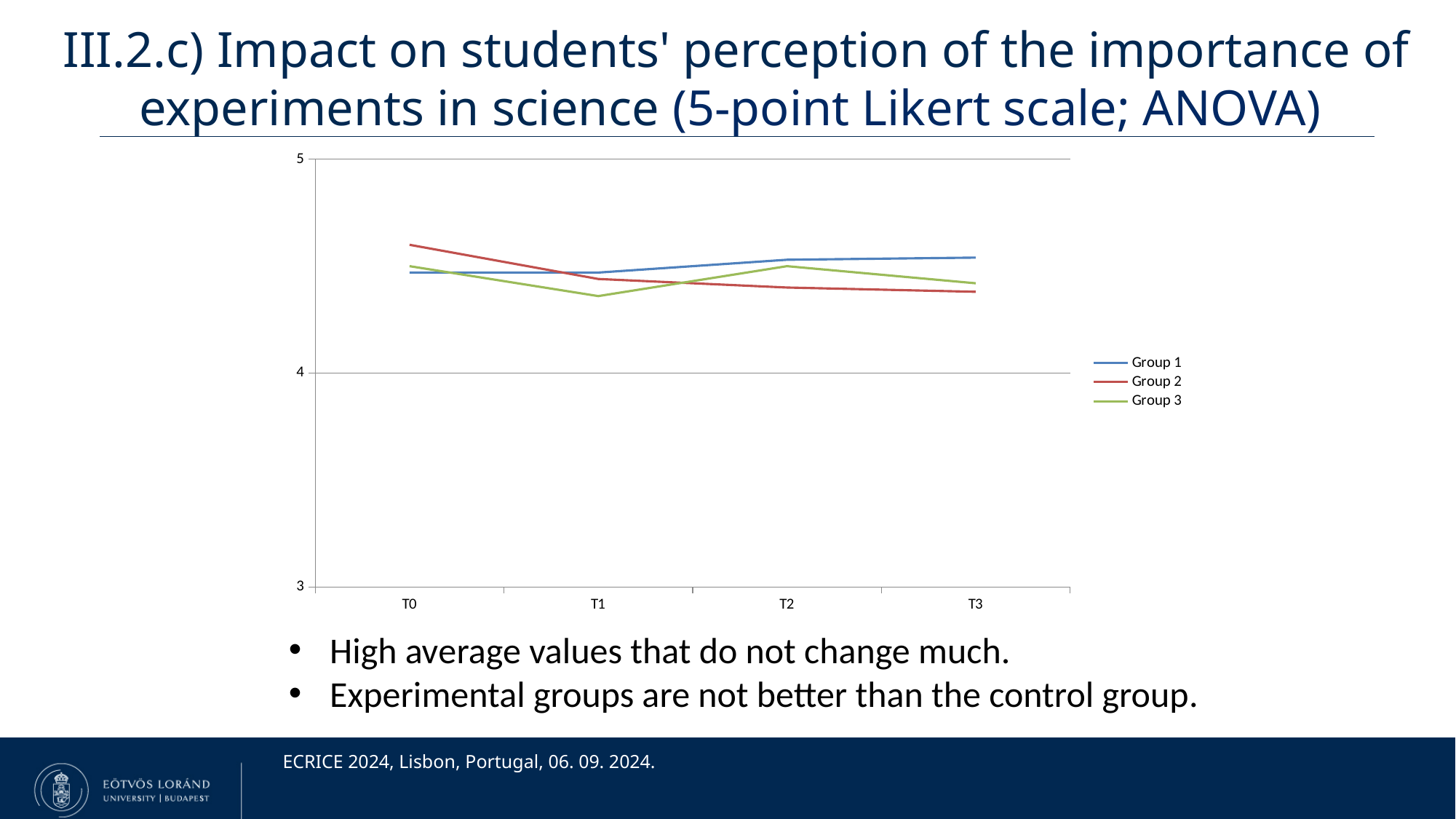
Does the value for Group 1 rise or fall from T0 to T3? rise At T3, which is larger: the value for Group 1 or the value for Group 2? Group 1 Which group has the lowest value at T1? Group 3 What kind of chart is shown on the slide? line chart What are the entries listed in the legend? Group 1, Group 2, Group 3 How many time points are shown on the x axis? 4 Is the value for Group 2 at T3 greater or less than 4? greater Does the value for Group 2 rise or fall from T0 to T3? fall Which group has the lowest value at T3? Group 2 Which group has the highest value at T3? Group 1 How many series does the legend list? 3 Which group has the highest value at T0? Group 2